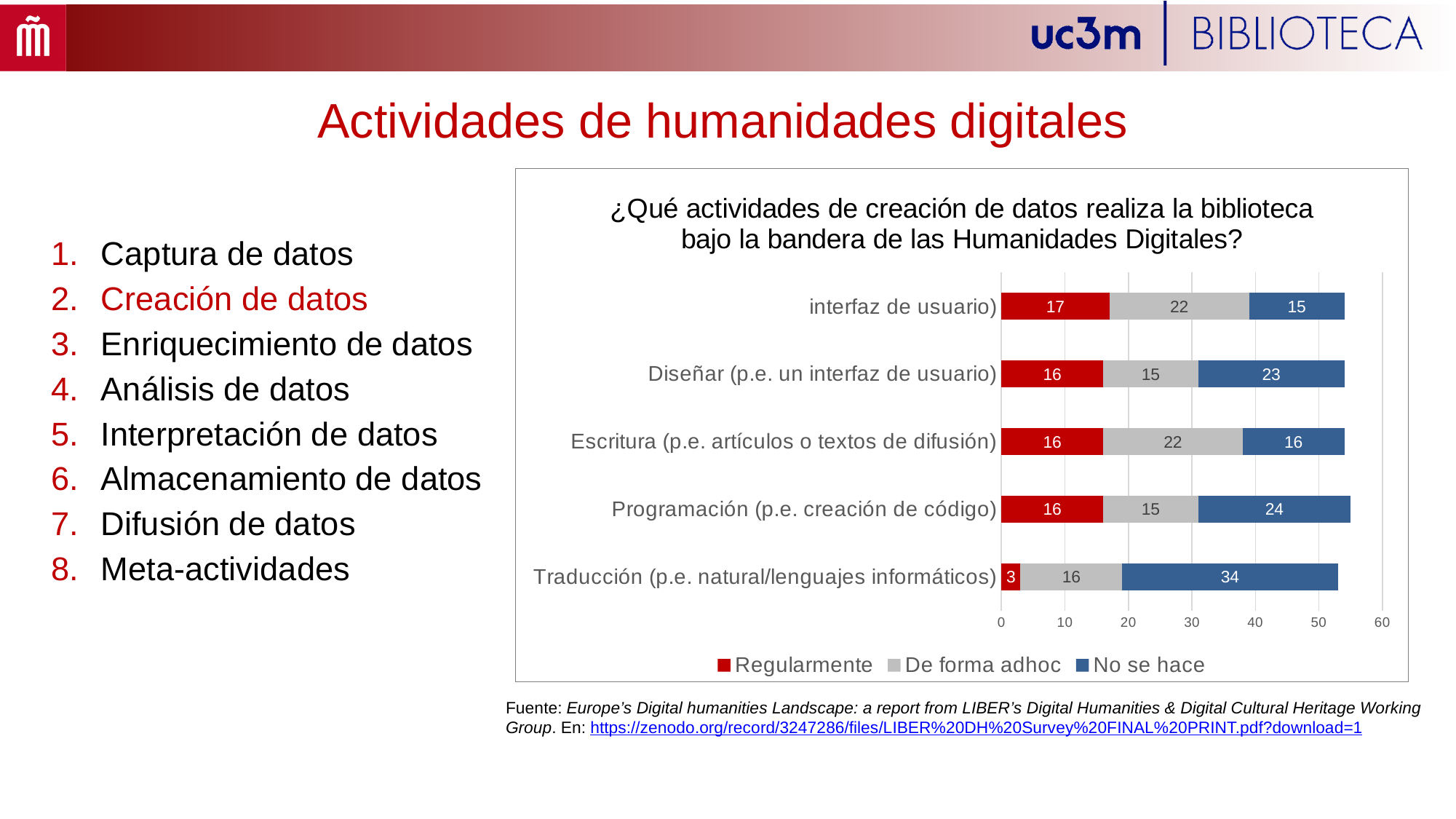
What is the value for "De forma adhoc" for Escritura (p.e. artículos o textos de difusión)? 22 What is the total of the stacked bar for Traducción (p.e. natural/lenguajes informáticos)? 53 How many categories are shown in the chart? 5 Which category has the lowest value for "Regularmente"? Traducción (p.e. natural/lenguajes informáticos) Which has the larger "De forma adhoc" value: Escritura (p.e. artículos o textos de difusión) or Diseñar (p.e. un interfaz de usuario)? Escritura (p.e. artículos o textos de difusión) Which category has the highest value for "No se hace"? Traducción (p.e. natural/lenguajes informáticos) What is the difference between the "No se hace" values for Traducción (p.e. natural/lenguajes informáticos) and Programación (p.e. creación de código)? 10 What is the value for "No se hace" for Programación (p.e. creación de código)? 24 What is the value for "Regularmente" for Traducción (p.e. natural/lenguajes informáticos)? 3 How many series does the legend list? 3 What kind of chart is shown on the slide? Stacked bar chart Is the total of the stacked bar for Programación (p.e. creación de código) greater or less than 50? greater